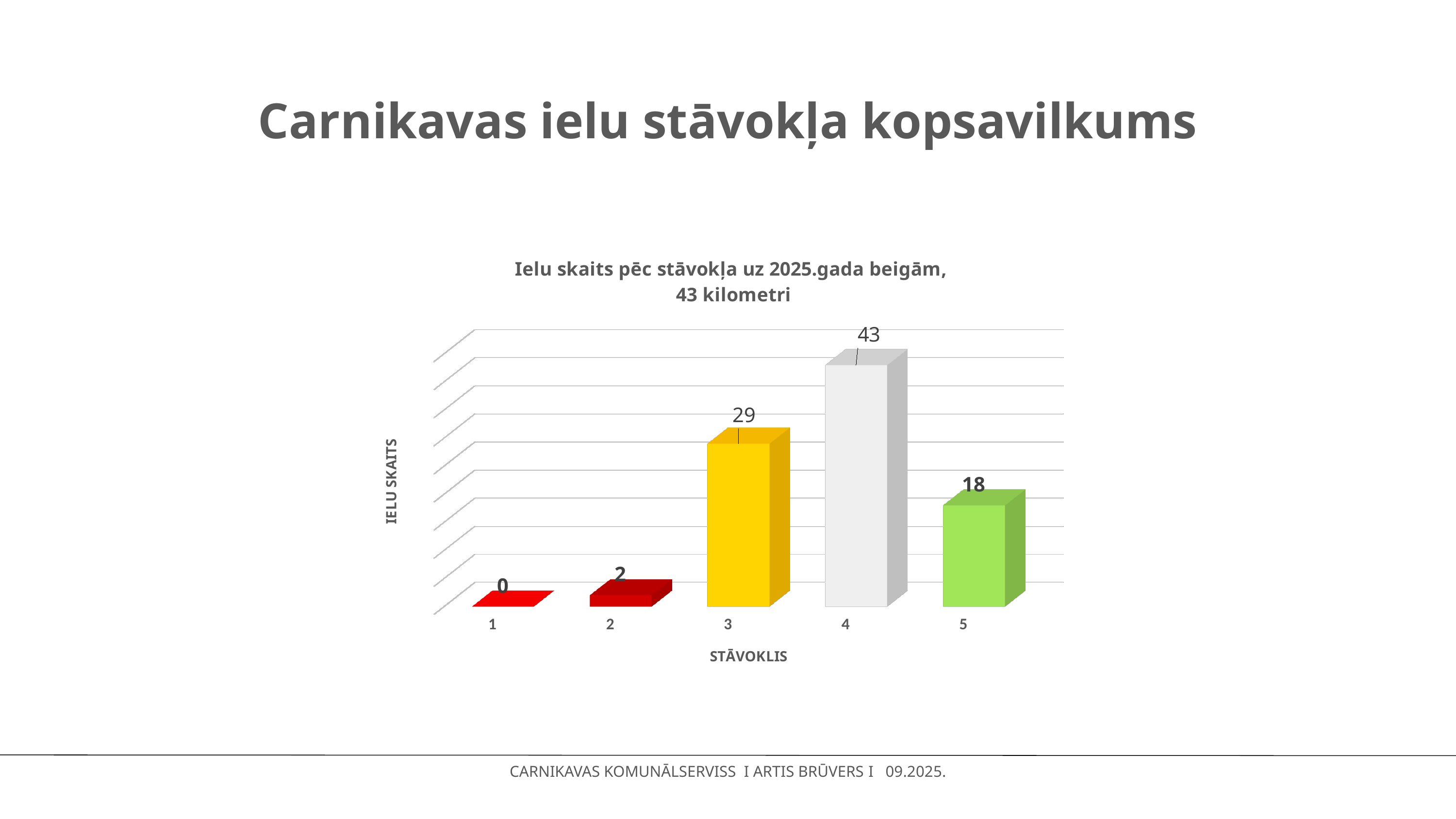
Which category has the lowest value? 1 Which category has the highest value? 4 What is the title of the chart? Ielu skaits pēc stāvokļa uz 2025.gada beigām, 43 kilometri What kind of chart is shown on the slide? bar chart What is the value for category 5? 18 What is the value for category 1? 0 What is the value for category 2? 2 What is the value for category 3? 29 What is the difference between the values for category 4 and category 3? 14 How many categories are shown on the x axis? 5 What is the value for category 4? 43 Which is larger, the value for category 3 or category 5? 3